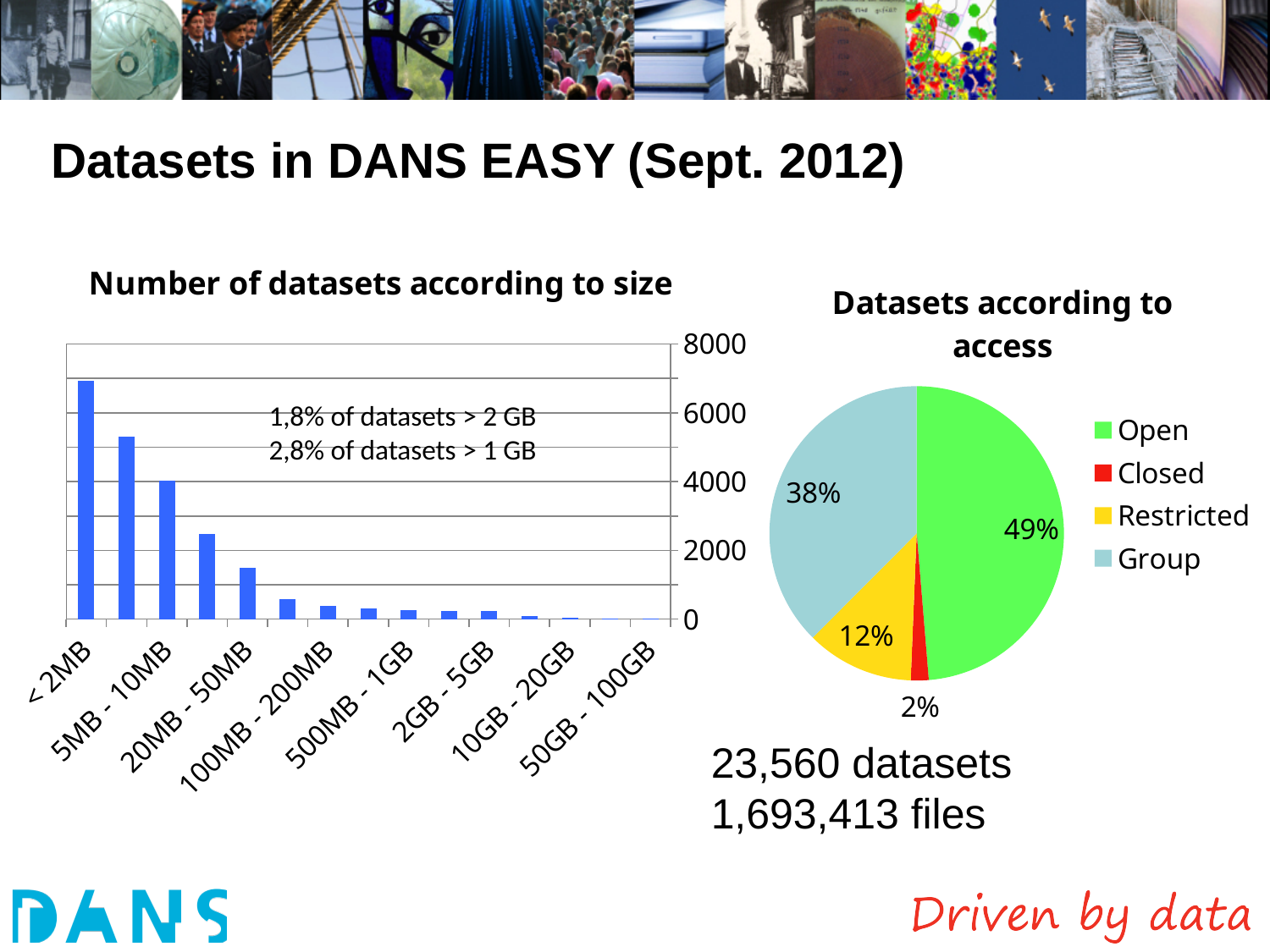
How many categories does the legend of the 'Datasets according to access' chart list? 4 In the 'Number of datasets according to size' chart, which size category has the highest number of datasets? < 2MB In the 'Number of datasets according to size' chart, is the value for '< 2MB' greater or less than 6000? greater In the 'Datasets according to access' pie chart, which access category has the largest share? Open What kind of chart is 'Number of datasets according to size'? Bar chart In the 'Number of datasets according to size' chart, do the values rise or fall as the size categories increase along the x axis? Fall In the 'Datasets according to access' pie chart, what share of datasets is Open? 49% In the 'Datasets according to access' pie chart, how many percentage points larger is the Open share than the Group share? 11 percentage points In the 'Datasets according to access' pie chart, which access category has the smallest share? Closed What kind of chart is 'Datasets according to access'? Pie chart In the 'Datasets according to access' pie chart, what share of datasets is Group? 38% In the 'Datasets according to access' pie chart, what share of datasets is Restricted? 12%